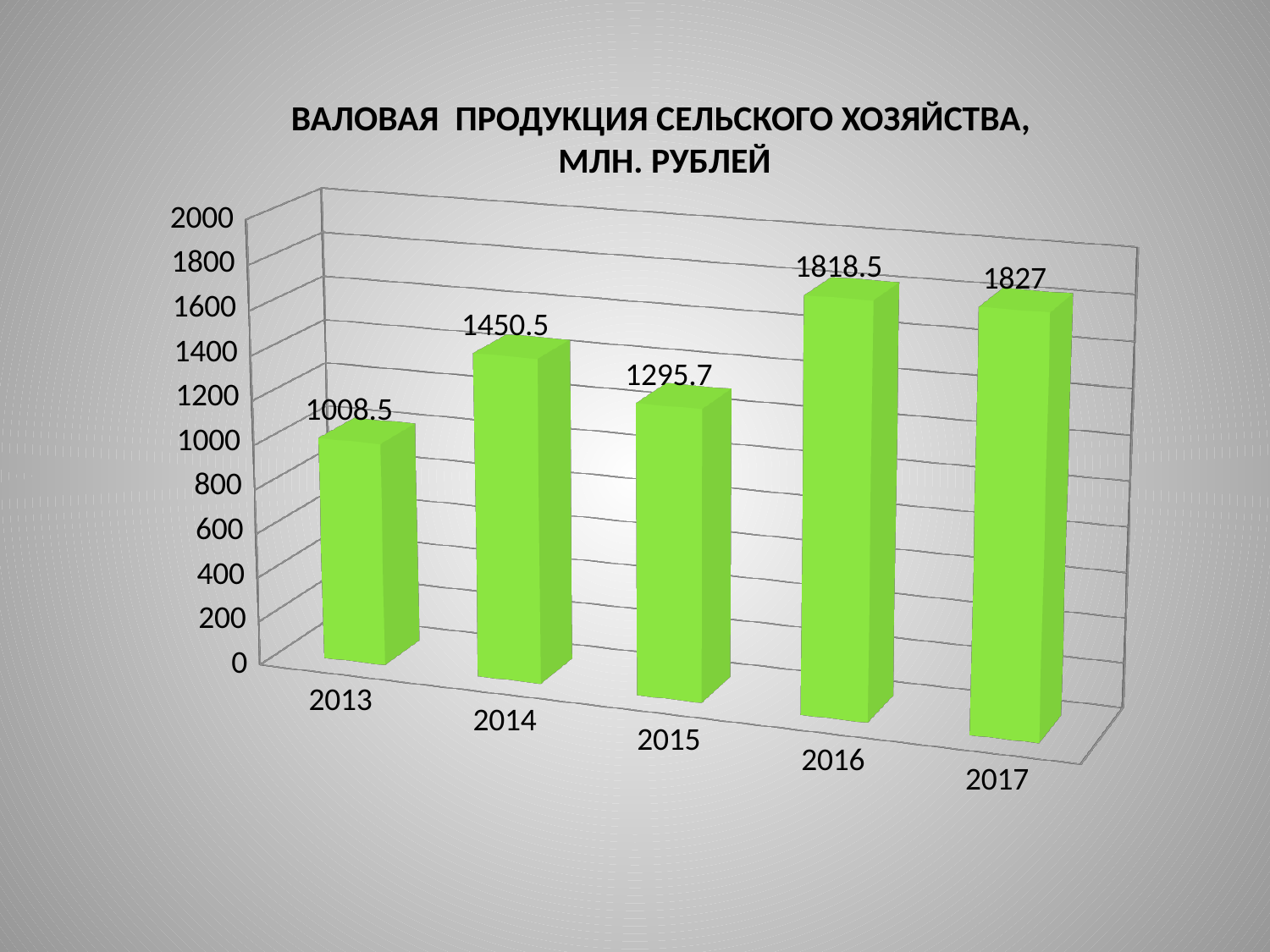
Which year has the highest value? 2017 How many years are shown on the chart? 5 Which year has the lowest value? 2013 What is the value for 2013? 1008.5 What is the title of the chart? ВАЛОВАЯ ПРОДУКЦИЯ СЕЛЬСКОГО ХОЗЯЙСТВА, МЛН. РУБЛЕЙ Which is larger, the value for 2014 or the value for 2015? 2014 What is the difference between the values for 2014 and 2013? 442 What kind of chart is this? bar chart What is the value for 2017? 1827 Is the value for 2016 greater or less than 1600? greater What is the value for 2015? 1295.7 What is the difference between the values for 2016 and 2015? 522.8